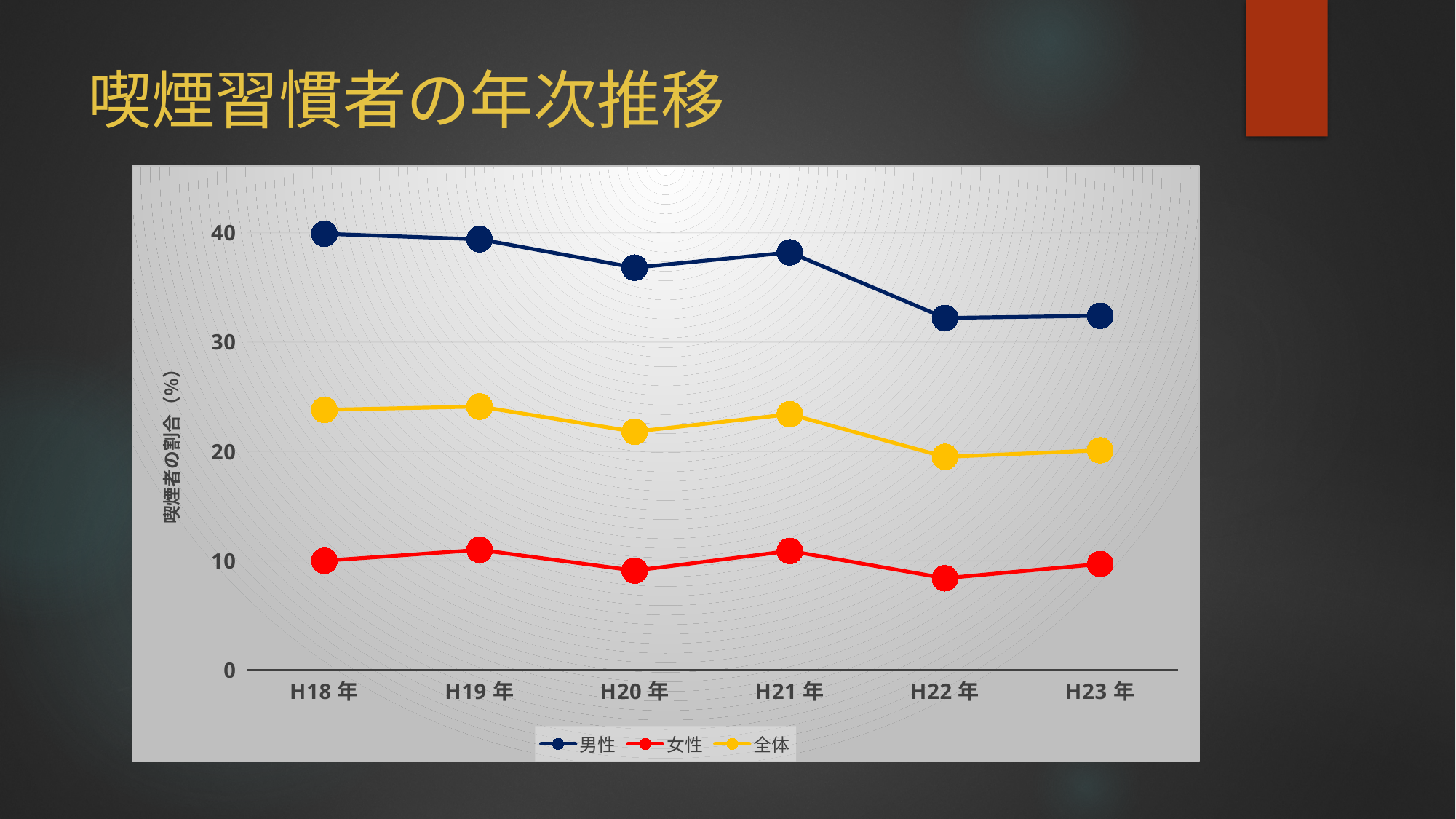
Is the value for 男性 in H18年 greater or less than 30? greater In which year is the value for 女性 lowest? H22年 Is the value for 全体 in H18年 greater or less than 20? greater Overall, does the 男性 line rise or fall from H18年 to H23年? fall How many series does the legend list? 3 Which is larger for 男性: the value in H18年 or the value in H22年? H18年 What kind of chart is shown on the slide? line chart Is the value for 男性 in H22年 greater or less than 40? less How many years are plotted along the x axis? 6 What is the title of the slide? 喫煙習慣者の年次推移 Which is larger for 全体: the value in H19年 or the value in H20年? H19年